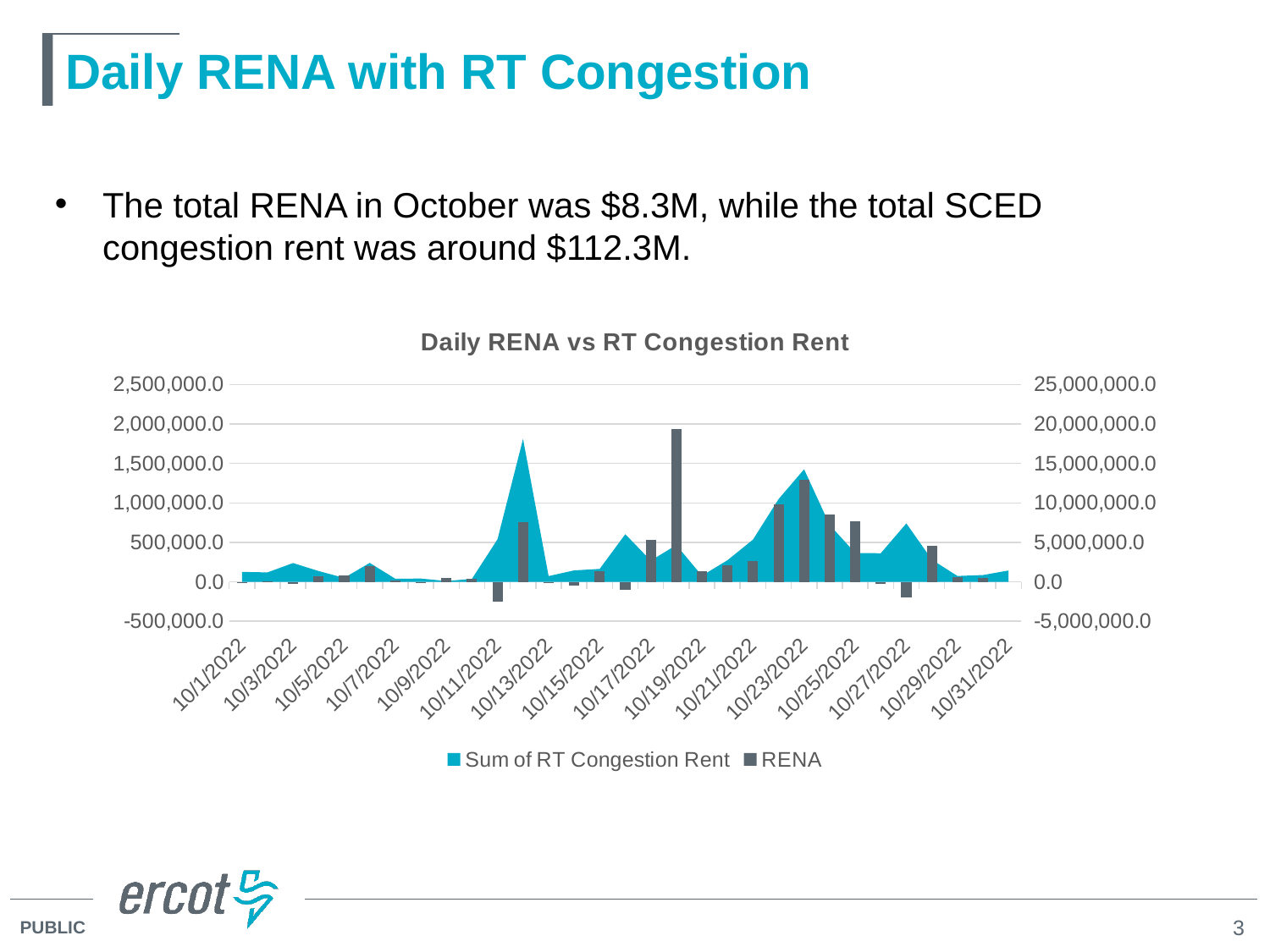
How many date labels are shown along the x axis? 16 What is the highest value shown on the left vertical axis? 2,500,000.0 What is the title of the chart? Daily RENA vs RT Congestion Rent What is the lowest value shown on the right vertical axis? -5,000,000.0 Is the highest point of the Sum of RT Congestion Rent area greater or less than 1,500,000.0 on the left axis? greater How many series does the chart legend list? 2